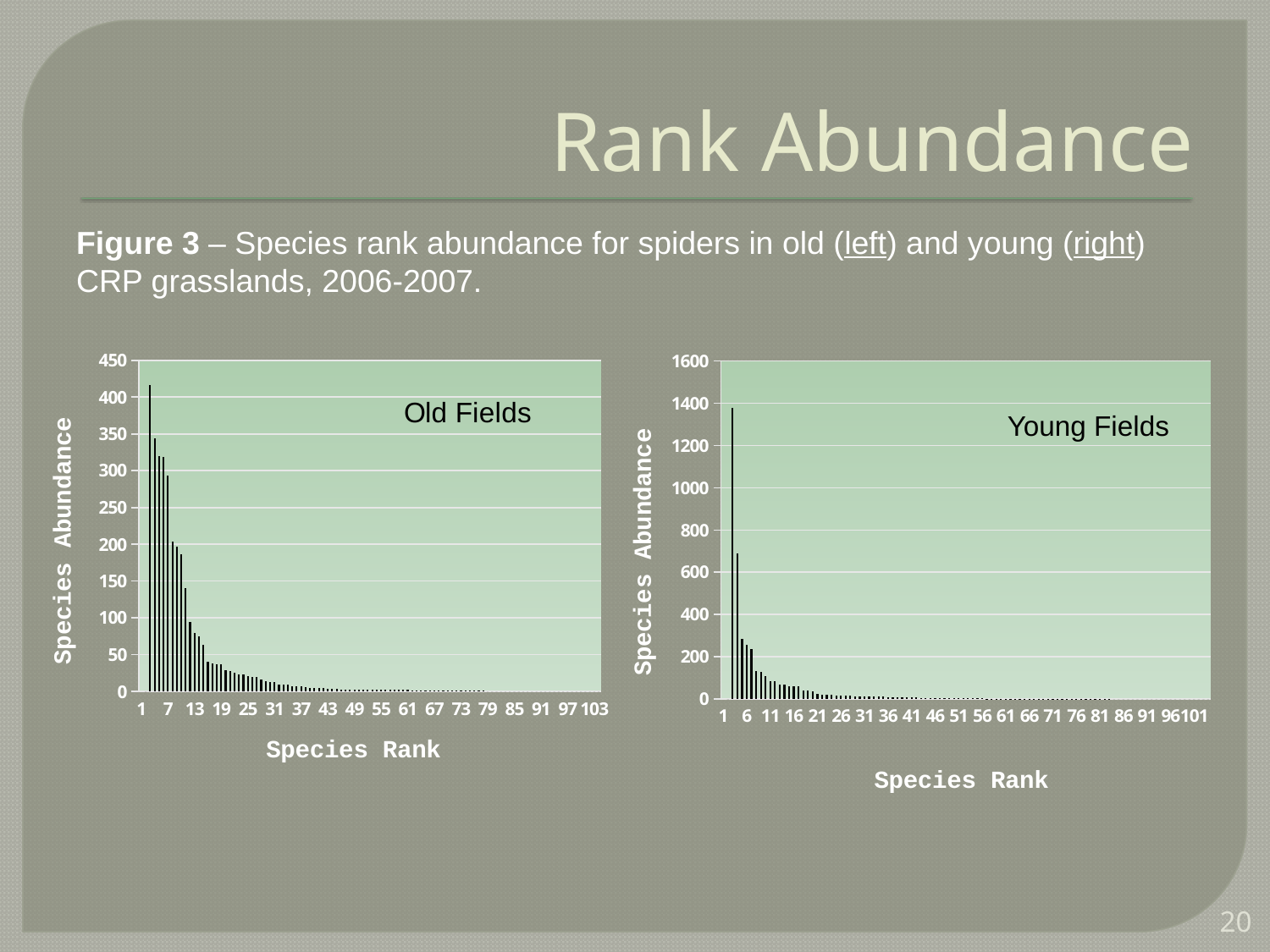
What is the x-axis title of the Young Fields chart? Species Rank In the Old Fields chart, which species rank has the highest abundance? 1 In the Old Fields chart, do the values rise or fall as species rank increases along the x axis? fall What is the y-axis title of the Old Fields chart? Species Abundance In the Young Fields chart, do the values rise or fall as species rank increases along the x axis? fall What kind of chart is the Old Fields chart on the left? bar chart In the Young Fields chart, which is larger, the value for species rank 1 or species rank 2? species rank 1 In the Young Fields chart, is the value for species rank 2 greater or less than 600? greater What kind of chart is the Young Fields chart on the right? bar chart In the Old Fields chart, is the value for species rank 1 greater or less than 400? greater In the Young Fields chart, which species rank has the highest abundance? 1 In the Young Fields chart, is the value for species rank 1 greater or less than 1200? greater